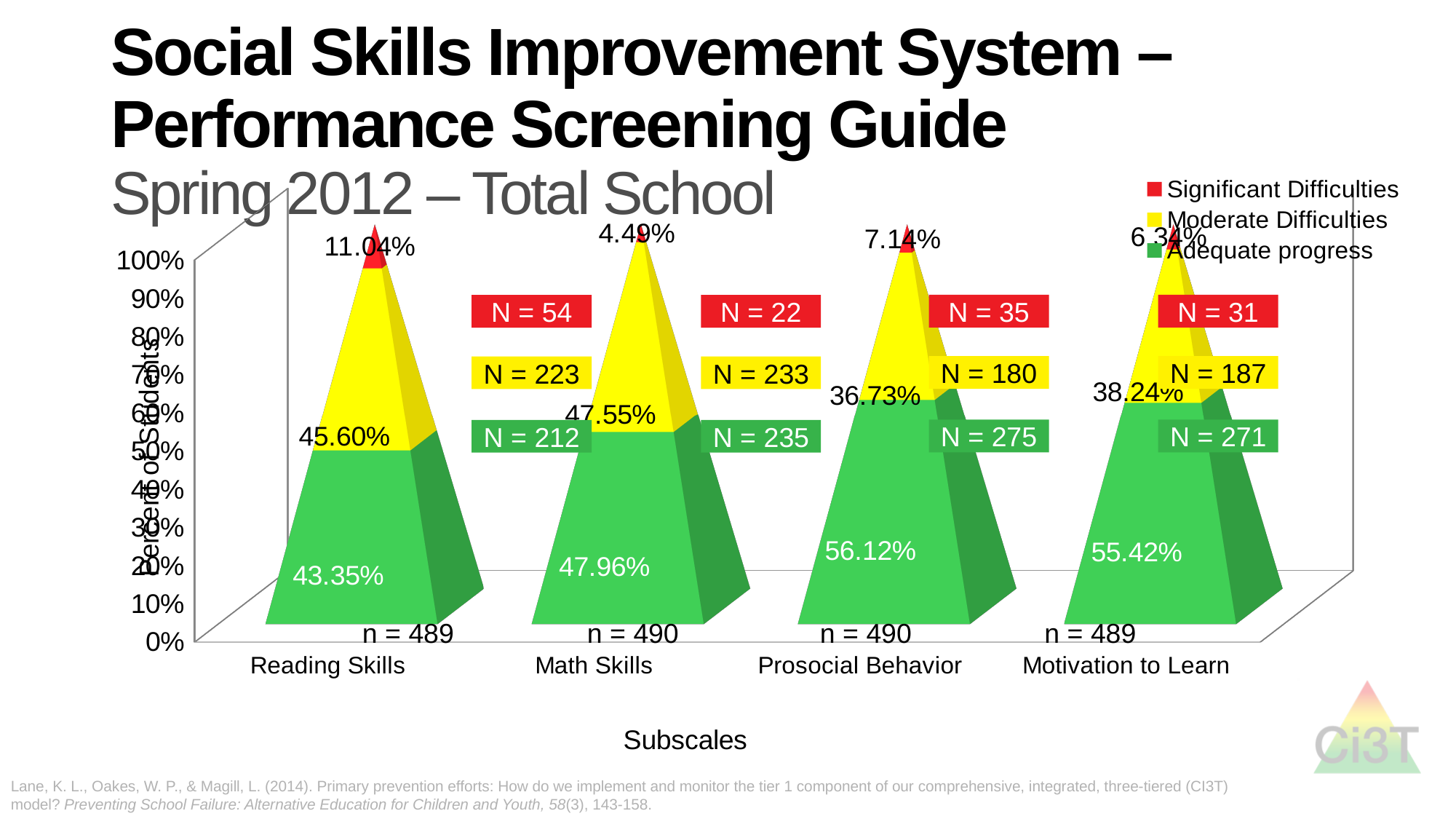
Which colour represents Moderate Difficulties in the legend? Yellow Which subscale has the highest Significant Difficulties percentage? Reading Skills Which is larger: the Moderate Difficulties percentage for Reading Skills or for Motivation to Learn? Reading Skills What is the Adequate progress percentage for Motivation to Learn? 55.42% How many subscales (categories) are shown on the x axis? 4 Which subscale has the lowest Adequate progress percentage? Reading Skills How many series does the legend list? 3 What is the Adequate progress percentage for Reading Skills? 43.35% What is the difference between the Adequate progress percentages for Prosocial Behavior and Reading Skills? 12.77% What is the Moderate Difficulties percentage for Prosocial Behavior? 36.73% What is the Significant Difficulties percentage for Math Skills? 4.49% What kind of chart is shown on the slide? Stacked bar chart (3D pyramid style)